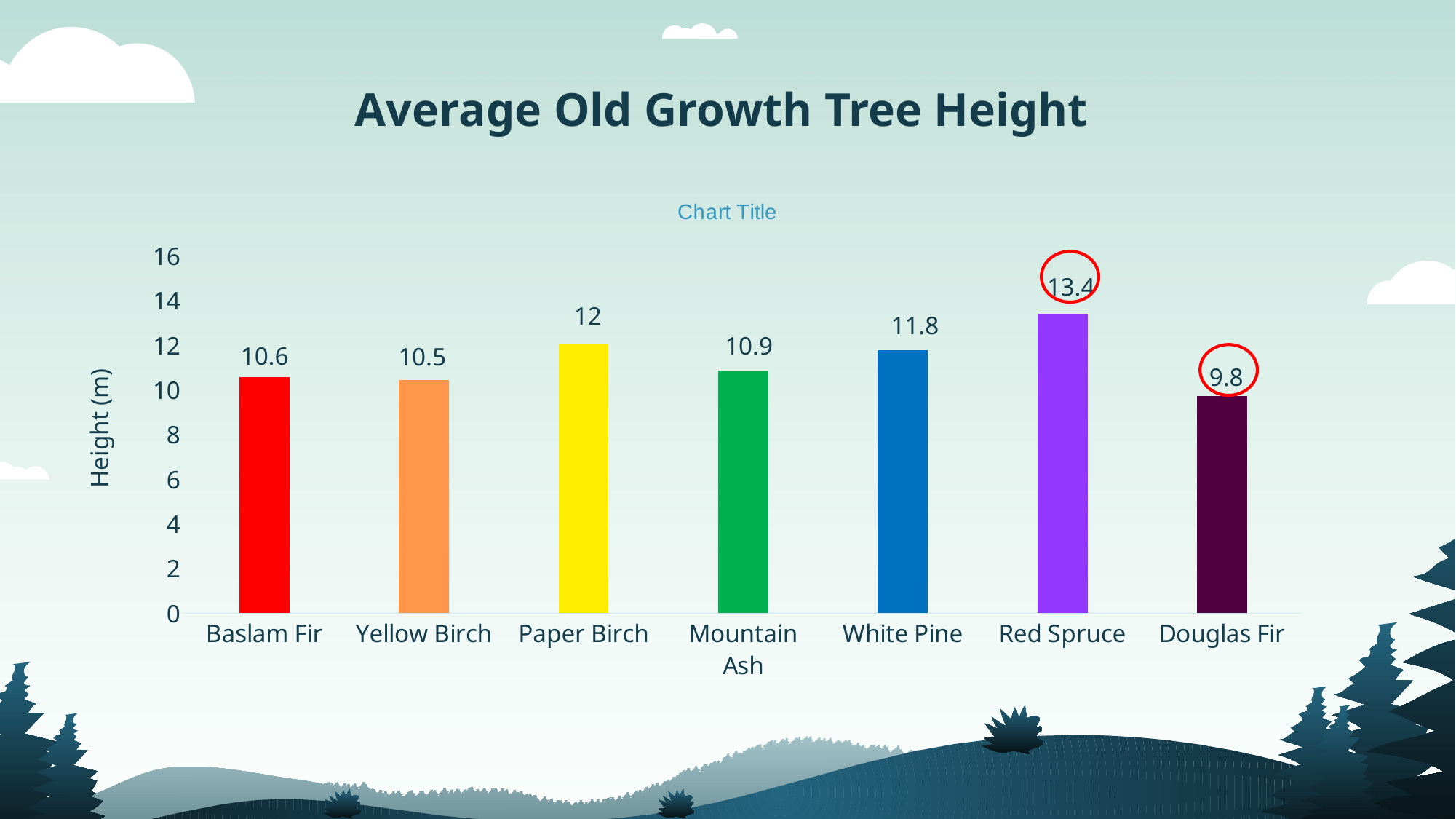
How many tree species are shown in the chart? 7 What is the label on the vertical axis of the chart? Height (m) Which tree species has the lowest average height? Douglas Fir What is the difference in height between White Pine and Yellow Birch? 1.3 What type of chart is shown on the slide? bar chart What is the difference in height between Red Spruce and Douglas Fir? 3.6 Is the value for Douglas Fir greater or less than 10? less What is the average height for Red Spruce? 13.4 Which tree species has the greatest average height? Red Spruce What is the average height for Paper Birch? 12 What is the average height for Mountain Ash? 10.9 Which is taller, Paper Birch or White Pine? Paper Birch